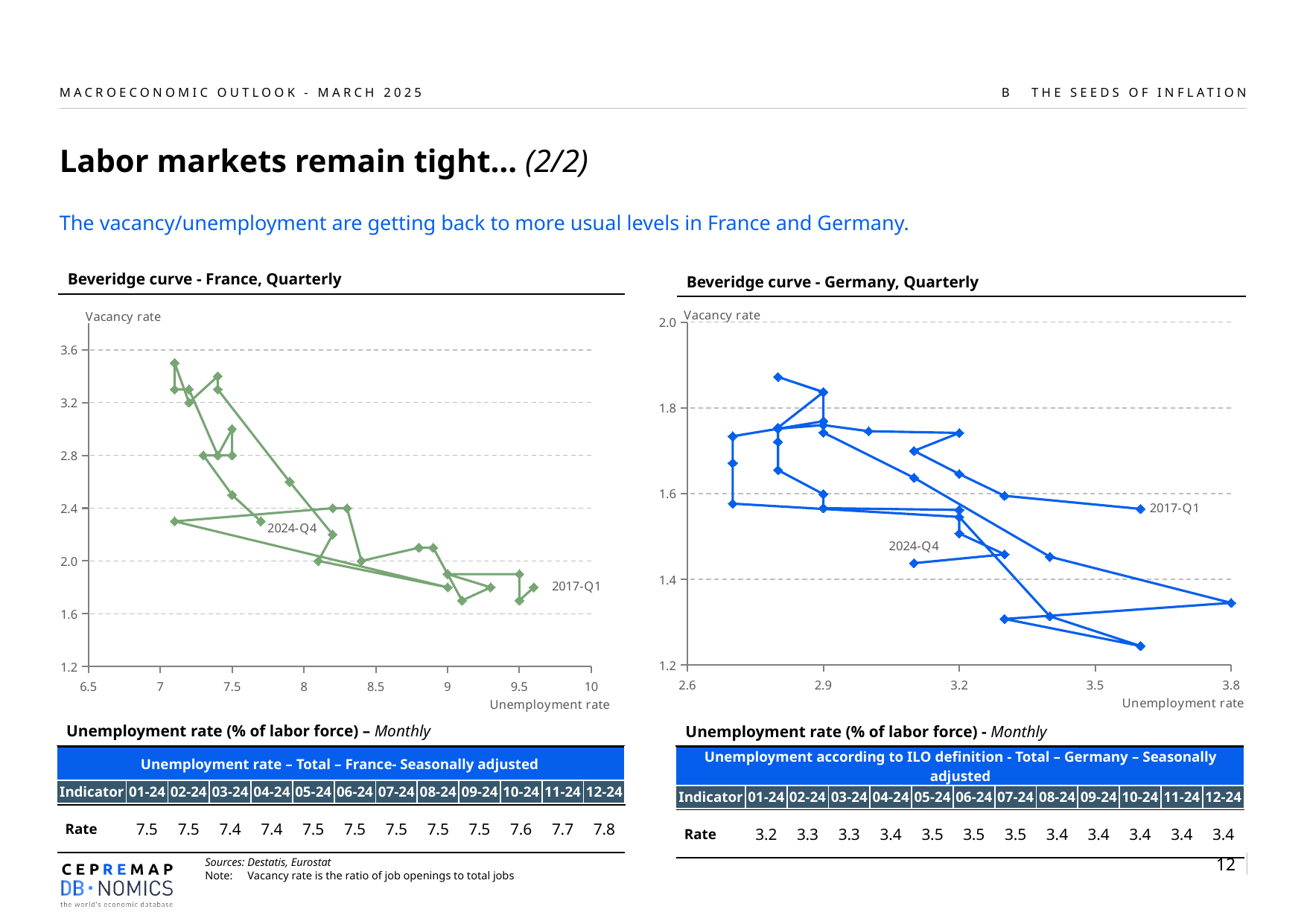
In the 'Beveridge curve - France, Quarterly' chart, is the vacancy rate at the point labelled 2017-Q1 greater or less than 2.0? less In the 'Beveridge curve - Germany, Quarterly' chart, which labelled point has the higher unemployment rate, 2017-Q1 or 2024-Q4? 2017-Q1 What kind of chart is the 'Beveridge curve - France, Quarterly' chart? Scatter (line) chart In the 'Beveridge curve - Germany, Quarterly' chart, is the vacancy rate at the point labelled 2017-Q1 greater or less than 1.4? greater In the 'Beveridge curve - Germany, Quarterly' chart, what is the label of the vertical axis? Vacancy rate In the 'Beveridge curve - France, Quarterly' chart, which labelled point has the higher vacancy rate, 2017-Q1 or 2024-Q4? 2024-Q4 In the 'Beveridge curve - France, Quarterly' chart, is the vacancy rate at the point labelled 2024-Q4 greater or less than 2.0? greater In the 'Beveridge curve - France, Quarterly' chart, what is the label of the horizontal axis? Unemployment rate